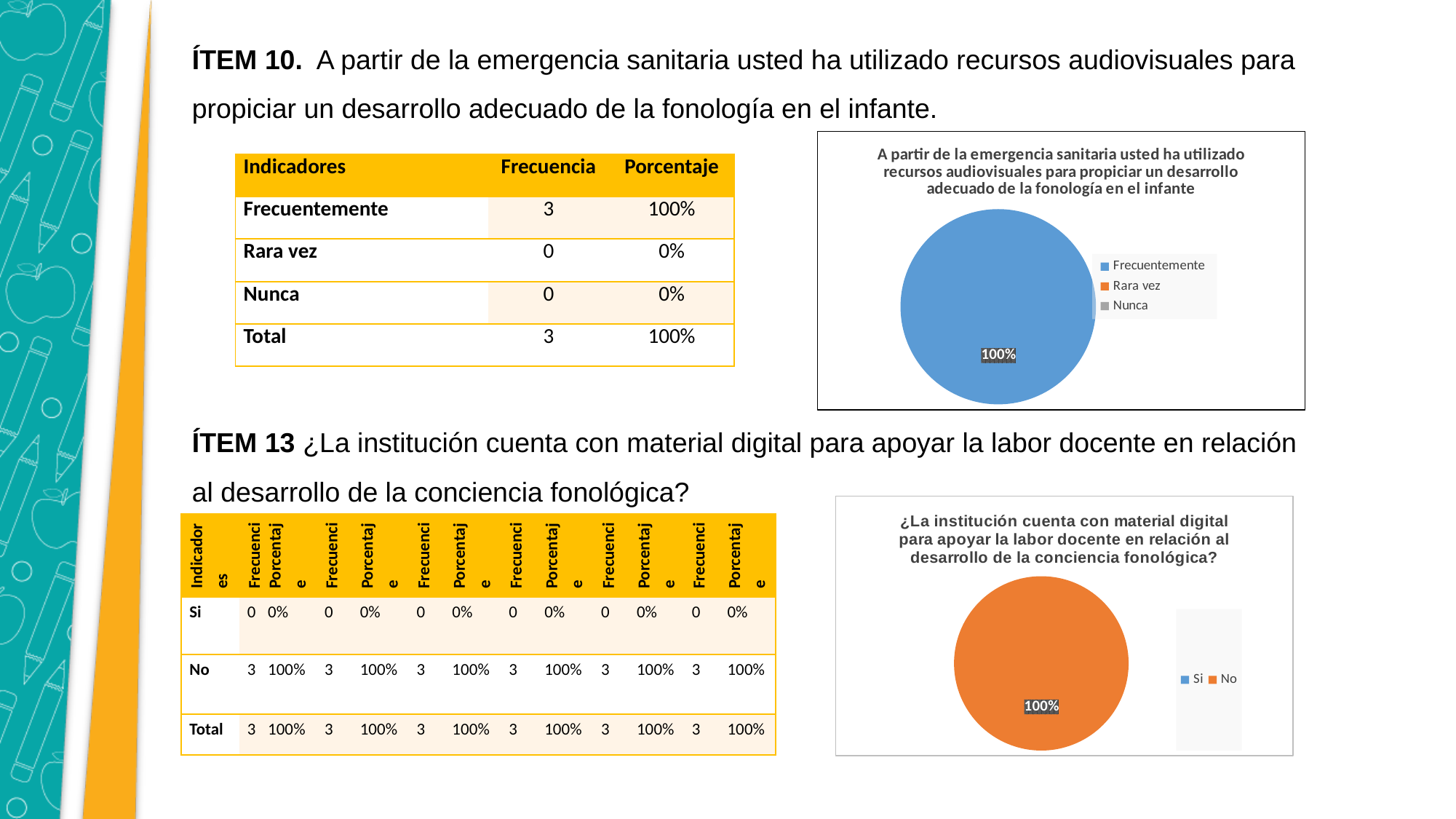
What kind of chart is the bottom chart on the slide, titled '¿La institución cuenta con material digital...'? Pie chart In the top pie chart, what percentage is shown on the data label of the single visible slice? 100% In the bottom pie chart, which category does the slice labelled 100% belong to? No In the top pie chart, which colour is used for the Frecuentemente category in the legend? Blue How many entries does the legend of the bottom pie chart list? 2 In the top pie chart, what share of the pie does the Frecuentemente slice take? 100% In the bottom pie chart, what share of the pie does the No slice take? 100% What kind of chart is the top chart on the slide, titled 'A partir de la emergencia sanitaria usted ha utilizado recursos audiovisuales...'? Pie chart In the top pie chart, which category does the slice labelled 100% belong to? Frecuentemente How many entries does the legend of the top pie chart list? 3 In the bottom pie chart, which colour is used for the No category in the legend? Orange In the bottom pie chart, what percentage is shown on the data label of the single visible slice? 100%